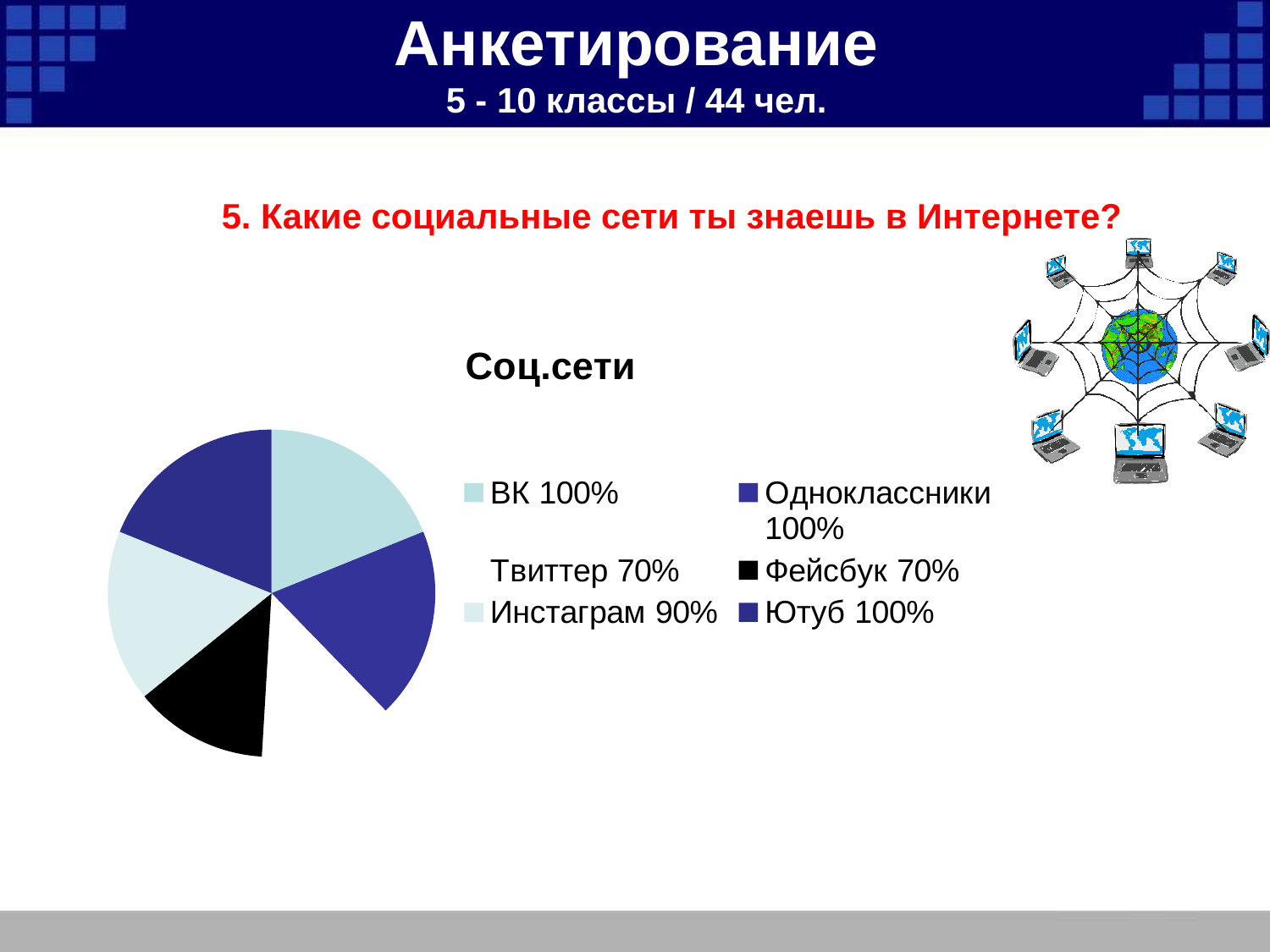
Which is larger, the value for Инстаграм or the value for Твиттер? Инстаграм Which category is shown in black in the pie chart? Фейсбук What kind of chart is shown on the slide? pie chart What is the difference between the value for Инстаграм and the value for Фейсбук? 20% How many categories does the pie chart have? 6 What value is shown for Ютуб? 100% What value is shown for Твиттер? 70% What is the difference between the value for ВК and the value for Твиттер? 30% Which is larger, the value for ВК or the value for Фейсбук? ВК What is the title of the chart? Соц.сети What value is shown for Фейсбук? 70% What value is shown for Инстаграм? 90%